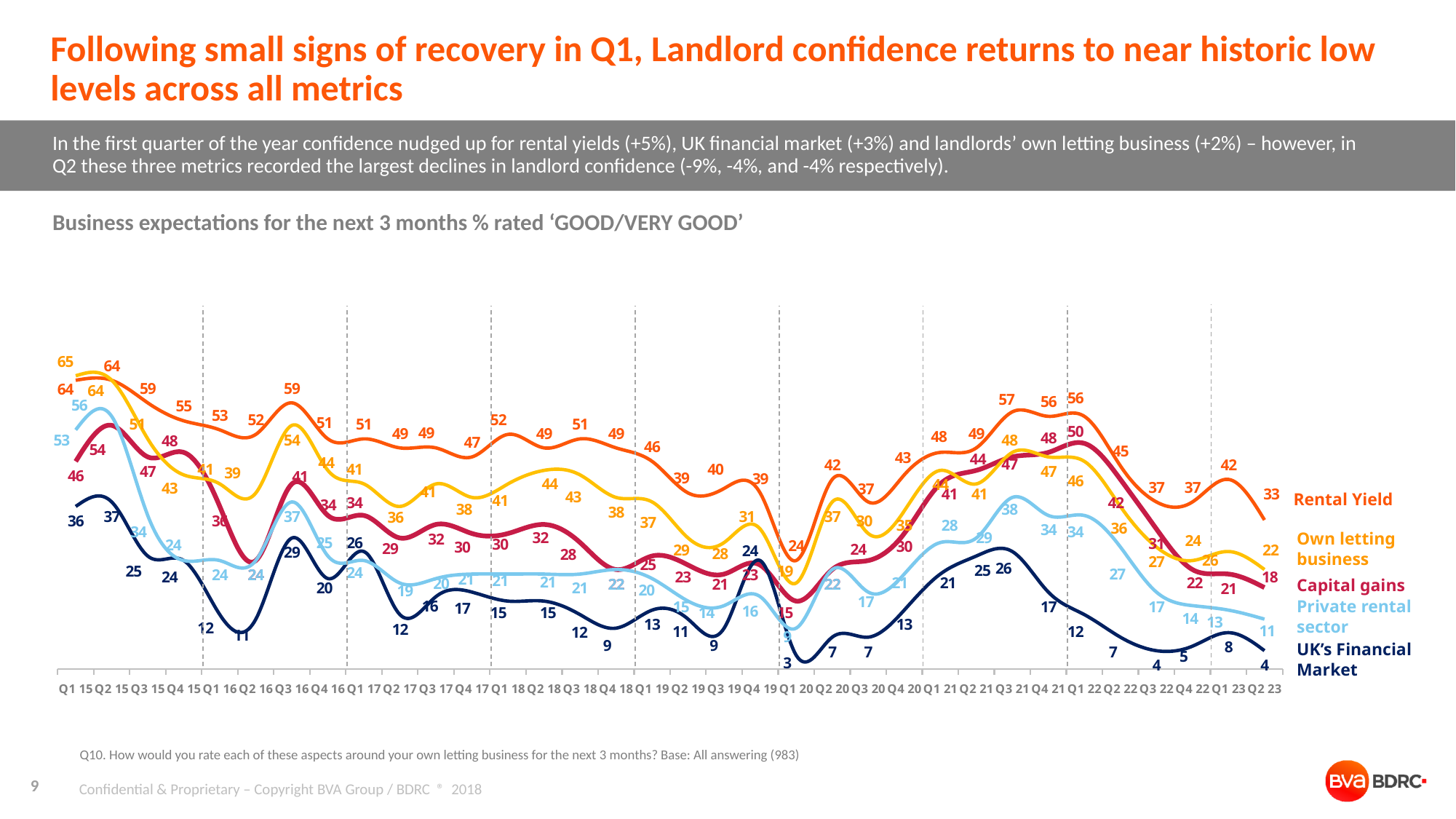
In Q1 22, which is higher: Capital gains or Own letting business? Capital gains What is the highest value recorded for the Own letting business series? 65 How many series are shown in the chart? 5 What is the UK's Financial Market value for Q1 20? 3 What is the Rental Yield value for Q2 23? 33 What is the Private rental sector value for Q2 23? 11 What type of chart is shown on the slide? Line chart By how much did Rental Yield fall from Q1 23 to Q2 23? 9 How many quarters are plotted along the x axis? 34 What is the title of the chart? Business expectations for the next 3 months % rated 'GOOD/VERY GOOD' What is the Own letting business value for Q1 15? 65 In which quarter does the UK's Financial Market series reach its lowest value? Q1 20